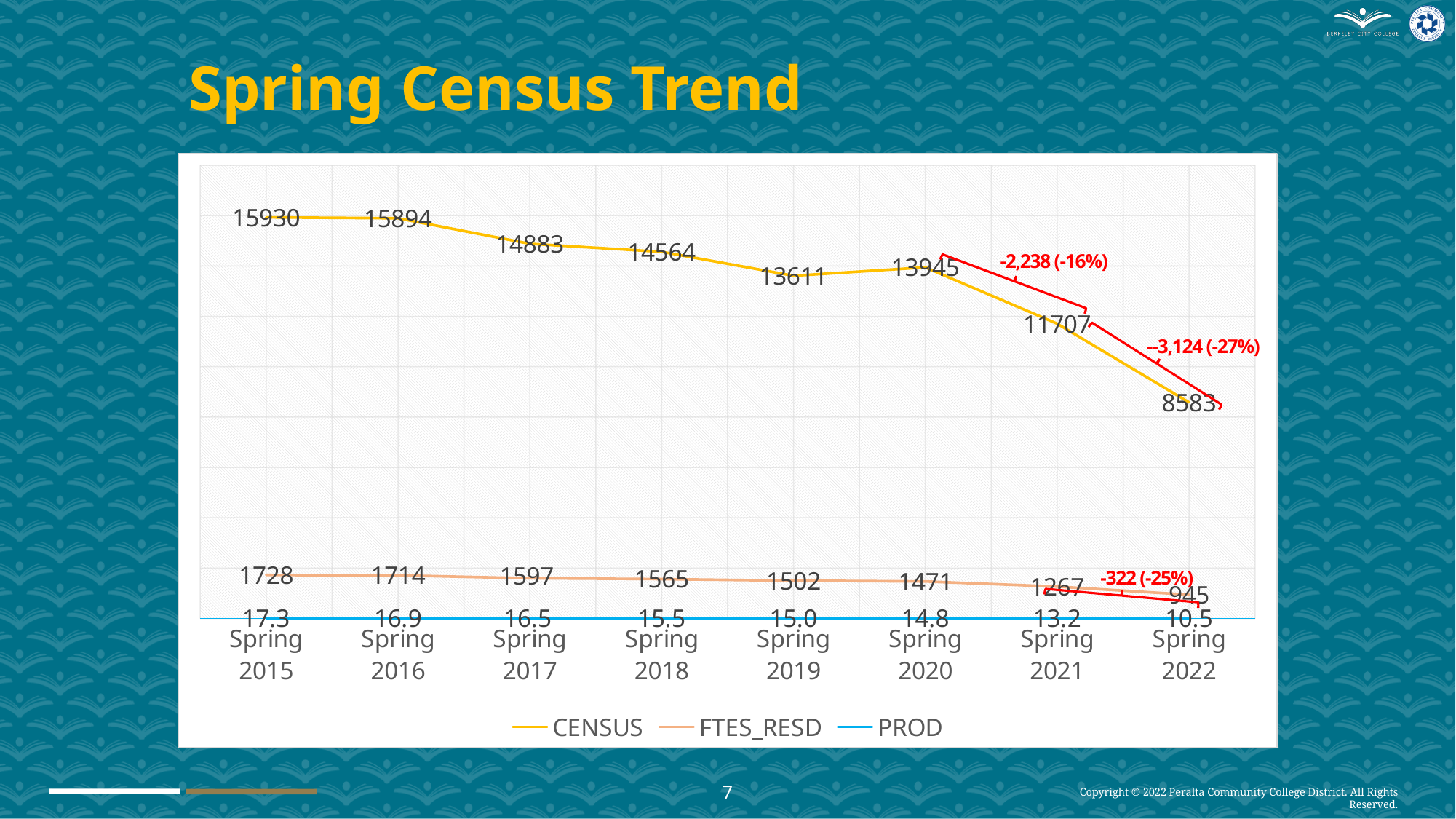
Which spring term has the lowest CENSUS value? Spring 2022 What is the PROD value for Spring 2022? 10.5 What is the difference between the CENSUS values for Spring 2020 and Spring 2021? 2238 How many series does the legend list? 3 Which is larger, the CENSUS value for Spring 2019 or for Spring 2020? Spring 2020 How many spring terms are shown on the x axis? 8 Which spring term has the highest FTES_RESD value? Spring 2015 What is the FTES_RESD value for Spring 2019? 1502 What kind of chart is shown on the slide? Line chart What is the title of the chart on the slide? Spring Census Trend What is the CENSUS value for Spring 2015? 15930 Does the PROD series rise or fall from Spring 2015 to Spring 2022? Fall